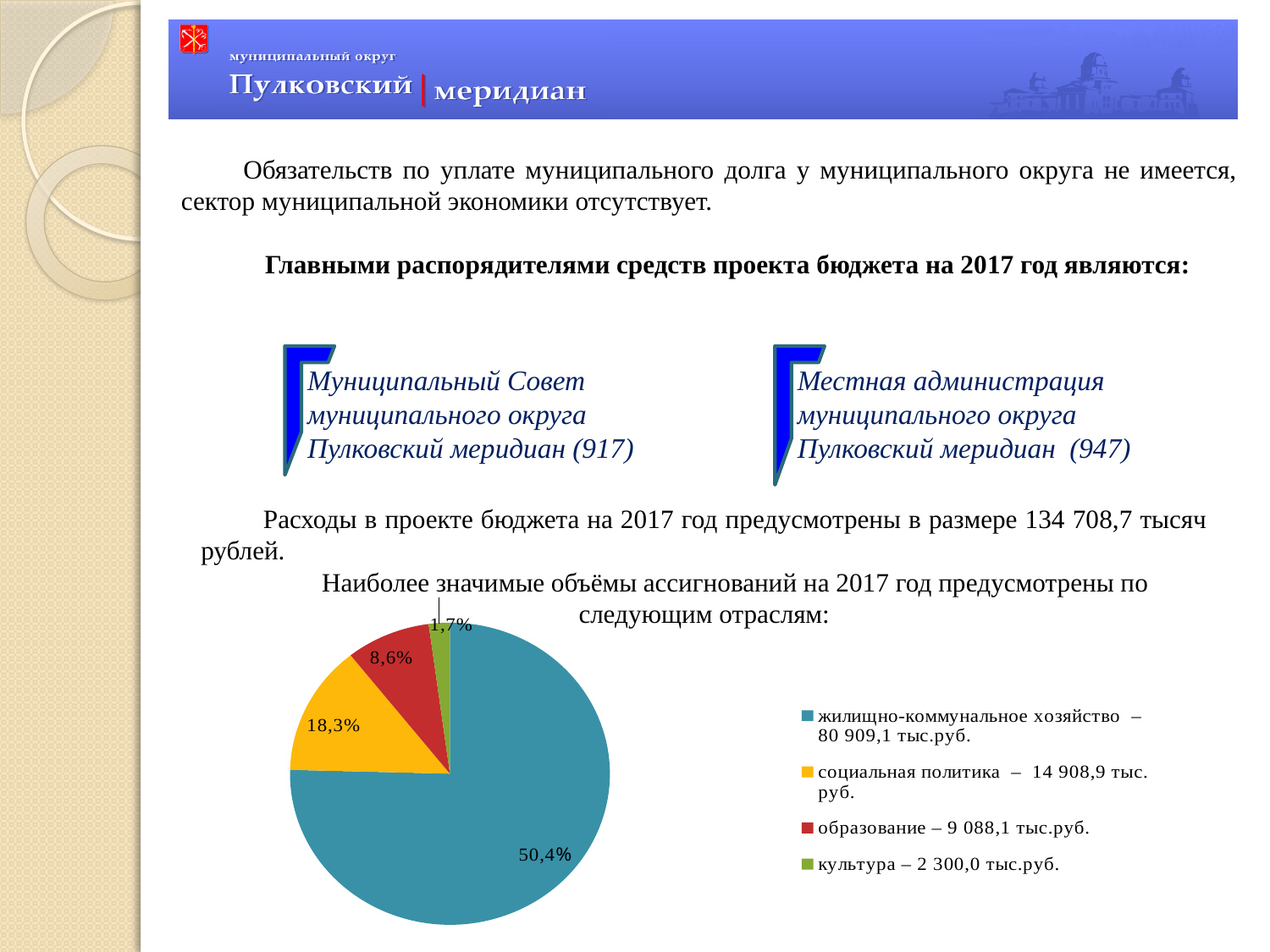
How many entries does the legend of the pie chart list? 4 What kind of chart is shown on the slide? pie chart What is the difference in percentage points between the slices for жилищно-коммунальное хозяйство and социальная политика? 32,1 Which category has the largest slice of the pie chart? жилищно-коммунальное хозяйство How many slices does the pie chart have? 4 According to the legend, what amount in тыс.руб. is allocated to социальная политика? 14 908,9 тыс. руб. What percentage is shown on the pie chart for культура? 1,7% What colour is the slice for образование in the pie chart? red What percentage is shown on the pie chart for жилищно-коммунальное хозяйство? 50,4% What percentage is shown on the pie chart for образование? 8,6% What percentage is shown on the pie chart for социальная политика? 18,3% Which category has the smallest slice of the pie chart? культура